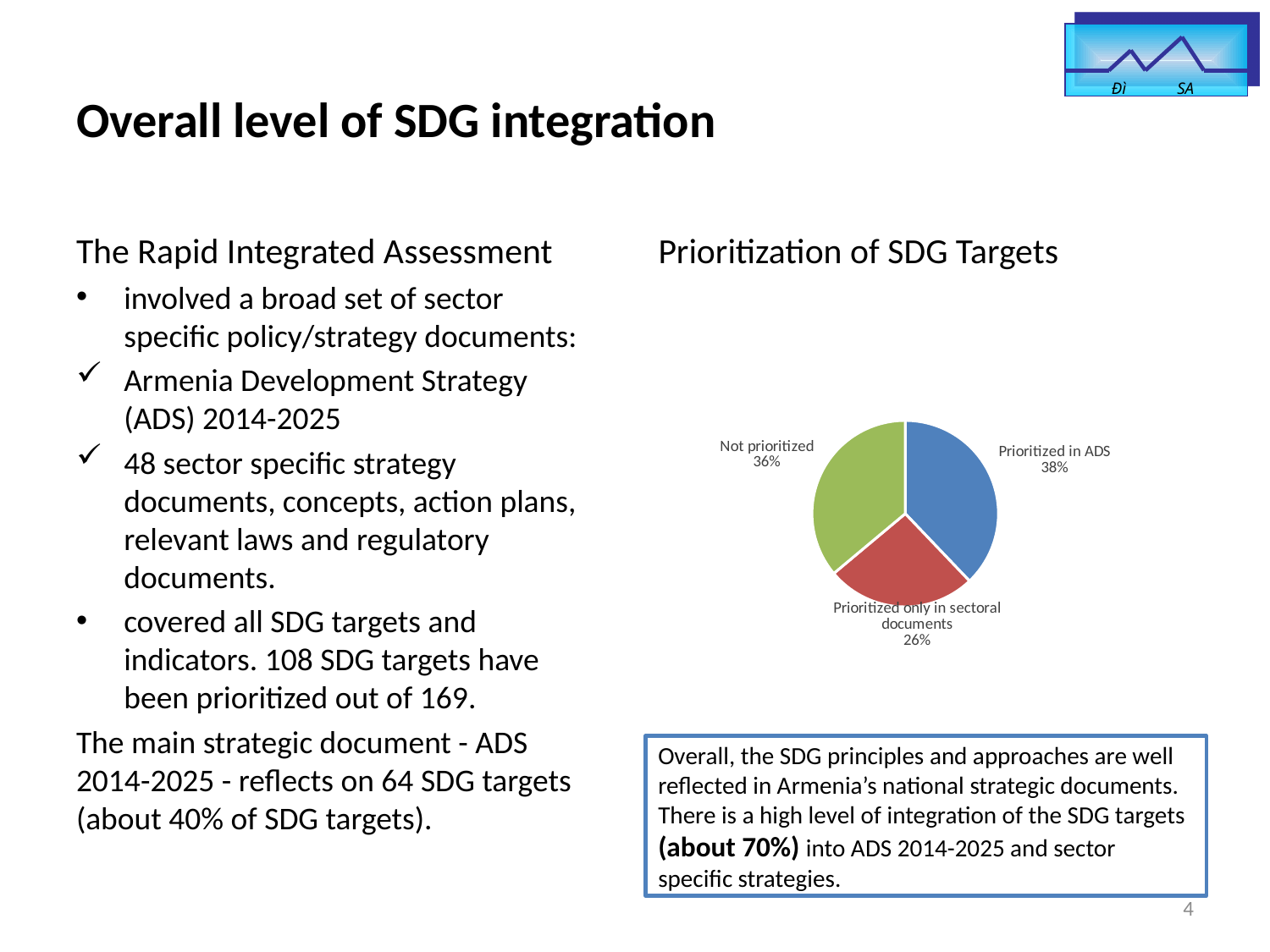
Which slice of the pie chart is the smallest? Prioritized only in sectoral documents Which is larger: the 'Not prioritized' slice or the 'Prioritized only in sectoral documents' slice? Not prioritized Which slice of the pie chart is the largest? Prioritized in ADS What share of SDG targets is labelled 'Not prioritized' in the pie chart? 36% What share of SDG targets is labelled 'Prioritized in ADS' in the pie chart? 38% What colour is the 'Not prioritized' slice of the pie chart? Green What is the combined share of the two 'Prioritized' slices in the pie chart? 64% What share of SDG targets is labelled 'Prioritized only in sectoral documents' in the pie chart? 26% What is the title of the chart on the slide? Prioritization of SDG Targets How many slices does the pie chart have? 3 What is the difference in percentage points between the 'Prioritized in ADS' slice and the 'Prioritized only in sectoral documents' slice? 12 What kind of chart is shown on the slide? Pie chart